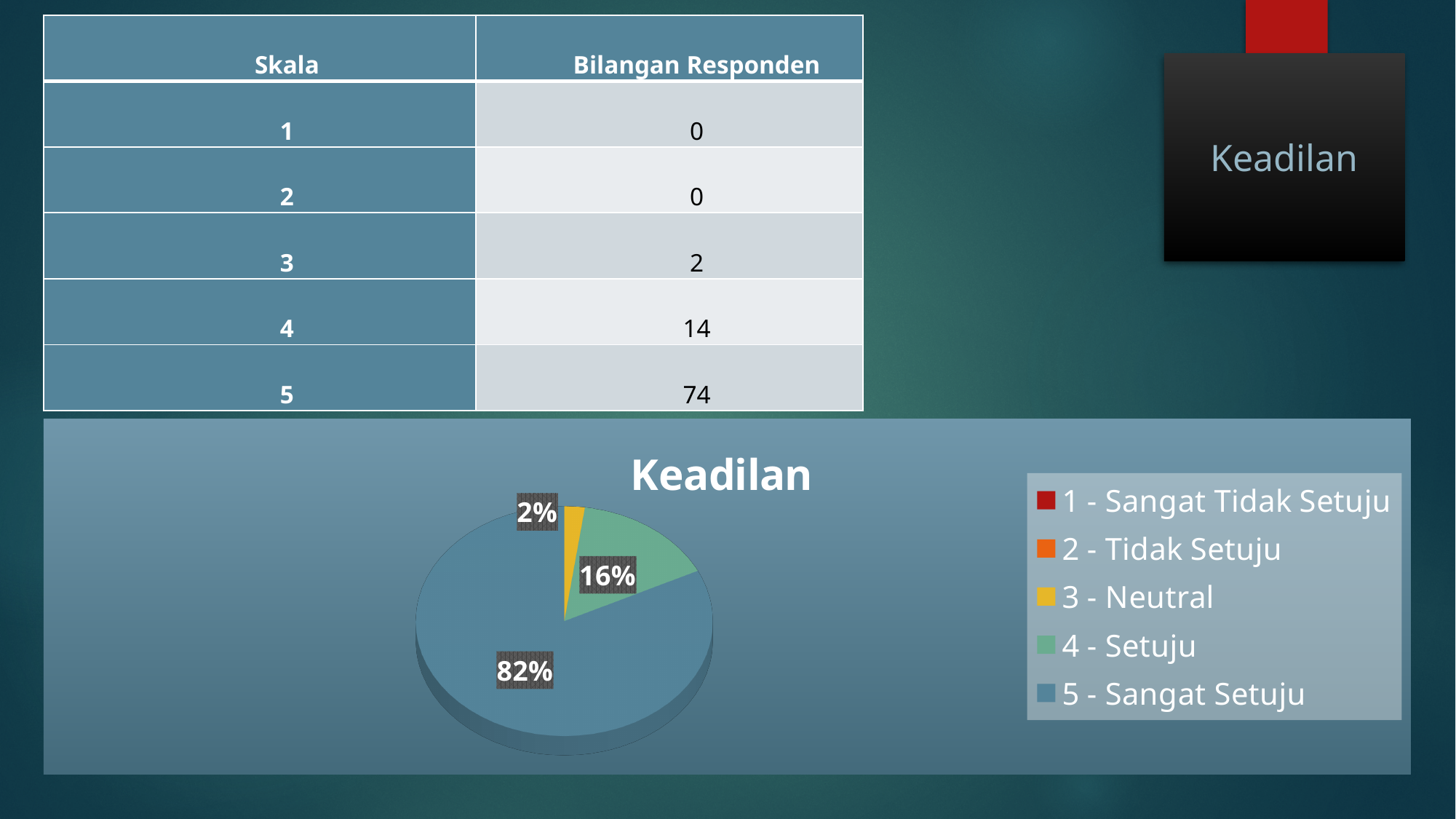
Which slice is larger, '4 - Setuju' or '3 - Neutral'? 4 - Setuju What is the title of the chart? Keadilan Which of the labelled slices is the smallest? 3 - Neutral What share of the pie does the '5 - Sangat Setuju' slice represent? 82% What is the difference in percentage points between the '5 - Sangat Setuju' slice and the '4 - Setuju' slice? 66 How many entries does the chart legend list? 5 What share of the pie does the '4 - Setuju' slice represent? 16% How many slices with a visible percentage label are shown on the pie? 3 What kind of chart is shown on the slide? pie chart What share of the pie does the '3 - Neutral' slice represent? 2% Which category has the largest slice of the pie? 5 - Sangat Setuju What colour is the '5 - Sangat Setuju' slice in the legend? blue